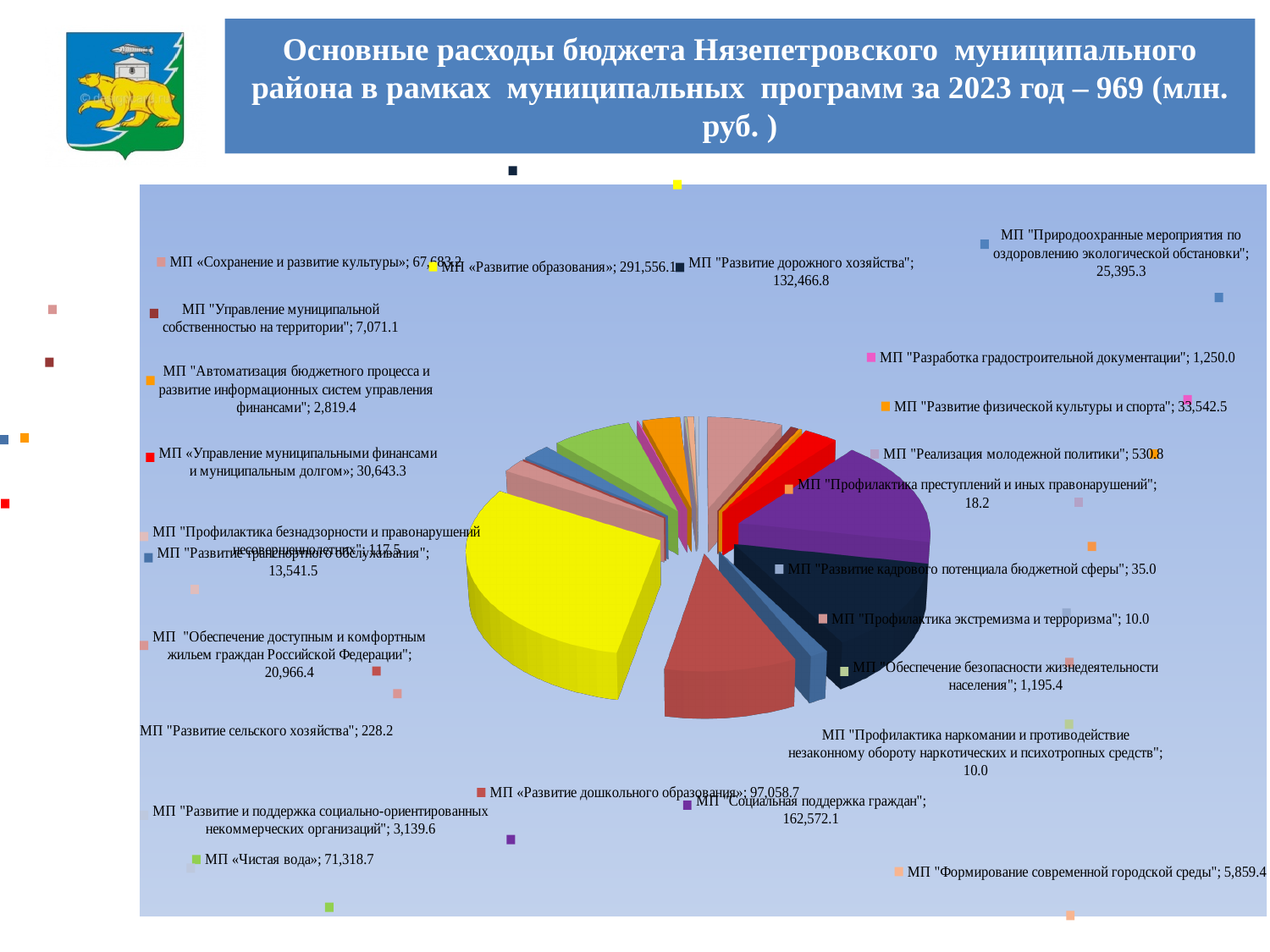
Which program has the largest slice of the pie? МП «Развитие образования» What is the value for МП "Природоохранные мероприятия по оздоровлению экологической обстановки"? 25,395.3 What kind of chart is shown on the slide? pie chart Which is larger: the value for МП «Управление муниципальными финансами и муниципальным долгом» or МП "Развитие транспортного обслуживания"? МП «Управление муниципальными финансами и муниципальным долгом» What is the value for МП "Развитие дорожного хозяйства"? 132,466.8 What is the value for МП «Развитие образования»? 291,556.1 What is the difference between the values for МП «Развитие образования» and МП "Социальная поддержка граждан"? 128,984.0 Which is larger: the value for МП "Развитие дорожного хозяйства" or МП «Развитие дошкольного образования»? МП "Развитие дорожного хозяйства" What is the value for МП "Развитие физической культуры и спорта"? 33,542.5 According to the slide title, what is the total of the main budget expenditures under municipal programs for 2023? 969 (млн. руб.) What is the value for МП "Социальная поддержка граждан"? 162,572.1 What is the value for МП «Чистая вода»? 71,318.7